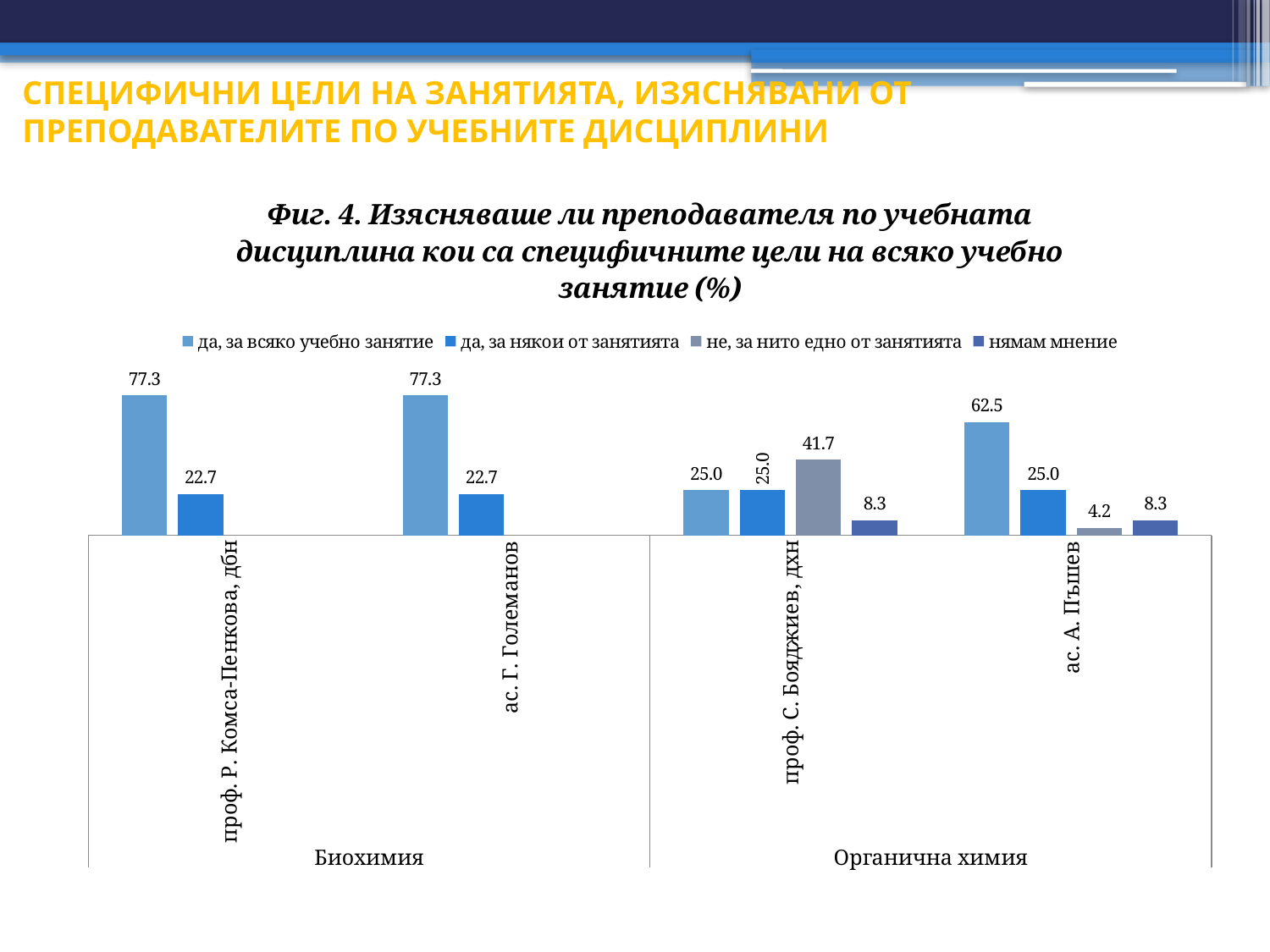
What is the value of "нямам мнение" for ас. А. Пъшев? 8.3 What is the value of "не, за нито едно от занятията" for проф. С. Бояджиев, дхн? 41.7 What type of chart is shown on the slide? bar chart What is the difference between the "да, за всяко учебно занятие" values for ас. Г. Големанов and ас. А. Пъшев? 14.8 For ас. А. Пъшев, which is larger: "да, за някои от занятията" or "не, за нито едно от занятията"? да, за някои от занятията How many series does the legend list? 4 Which teacher has the lowest value for "да, за всяко учебно занятие"? проф. С. Бояджиев, дхн What is the value of "да, за всяко учебно занятие" for проф. Р. Комса-Пенкова, дбн? 77.3 How many teachers (categories) are shown on the x axis? 4 What is the value of "да, за някои от занятията" for ас. Г. Големанов? 22.7 Which teacher has the highest value for "не, за нито едно от занятията"? проф. С. Бояджиев, дхн Which two subject groups are labelled along the bottom of the chart? Биохимия and Органична химия